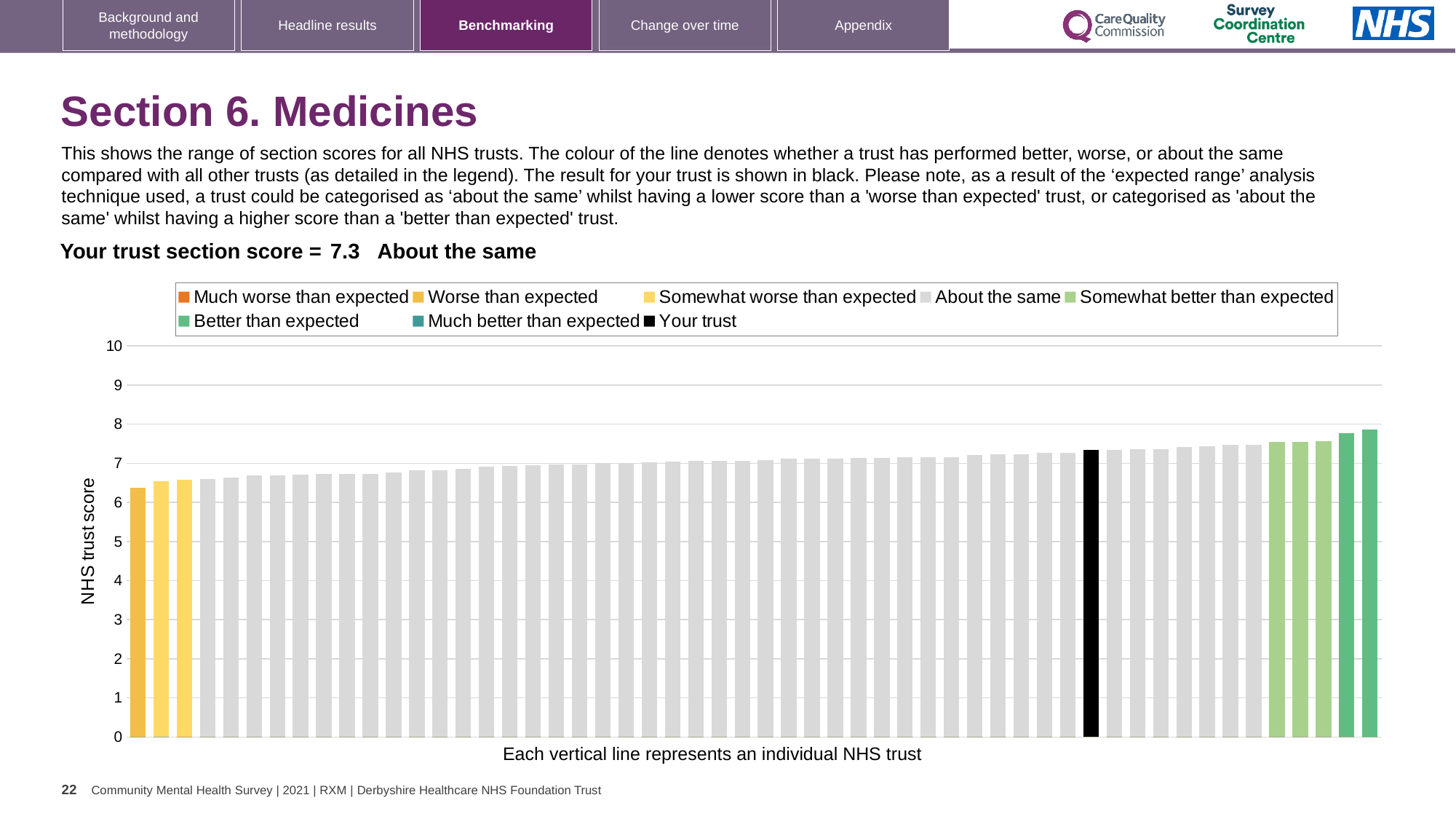
Is the value for your trust (the black bar) greater or less than 7? greater Do the bar values rise or fall from left to right along the x axis? rise How many entries does the chart legend list? 8 What kind of chart is shown on the slide? bar chart How many bars are coloured in the 'Worse than expected' yellow shade? 1 Is the value of the lowest bar in the chart greater or less than 7? less What is the label on the vertical axis of the chart? NHS trust score Which category is your trust placed in according to the text above the chart? About the same How many bars are coloured green (better than expected categories) at the right of the chart? 5 Is the value of the highest bar in the chart greater or less than 8? less What is the section score for your trust shown on the slide? 7.3